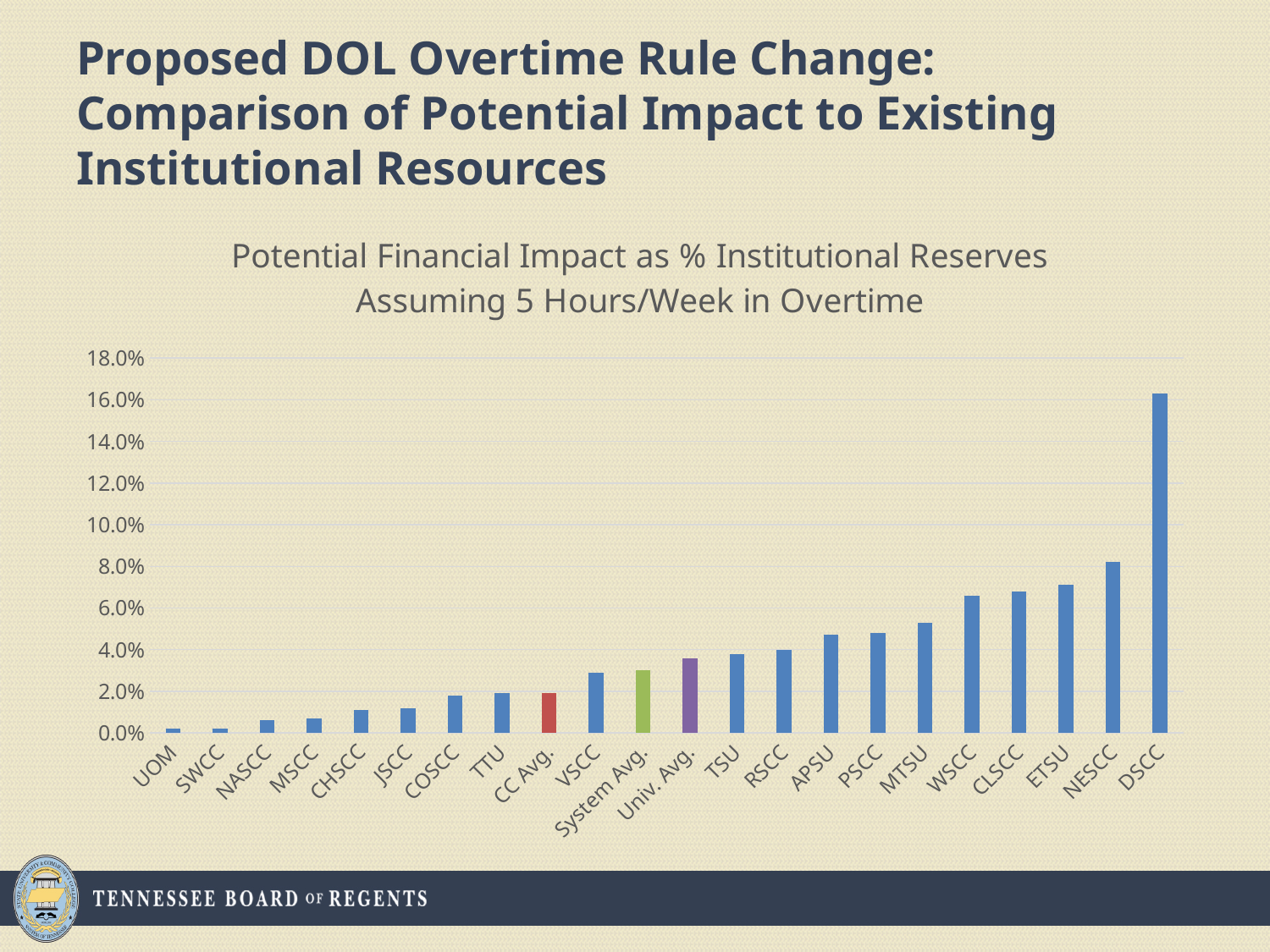
Which has a larger value, MTSU or TTU? MTSU Do the values generally rise or fall moving from left to right along the x axis? rise Is the value for System Avg. greater or less than 2.0%? greater Is the value for TTU greater or less than 4.0%? less Is the value for NESCC greater or less than 6.0%? greater How many categories are shown along the x axis of the chart? 22 What colour is the bar for CC Avg.? red Which has a larger value, DSCC or NESCC? DSCC Which institution has the highest potential financial impact as a percentage of institutional reserves? DSCC What kind of chart is shown on the slide? bar chart